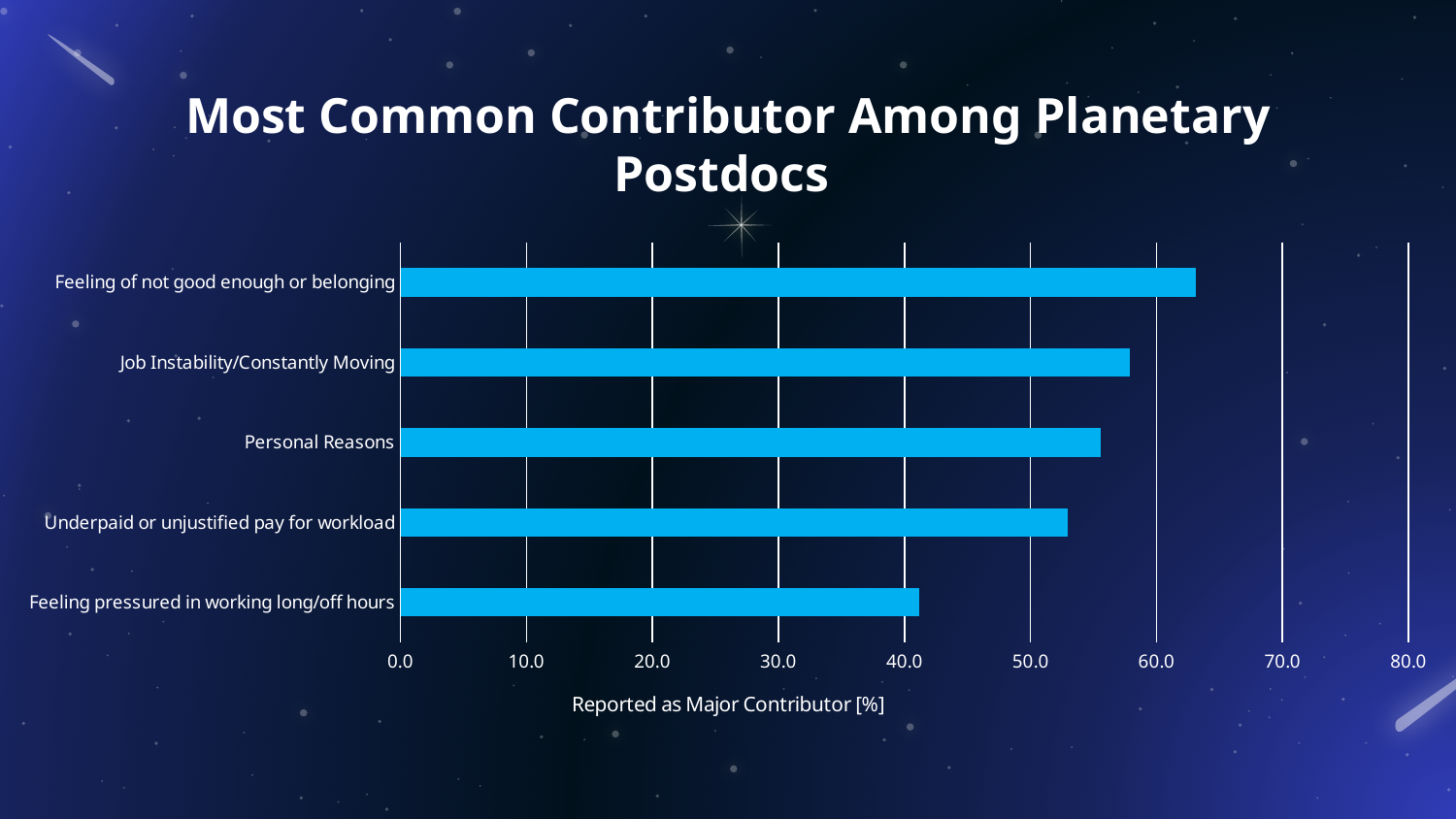
What kind of chart is shown on the slide? bar chart Is the value for Job Instability/Constantly Moving greater or less than 60.0? less Which category has the lowest reported percentage? Feeling pressured in working long/off hours What is the label of the horizontal axis? Reported as Major Contributor [%] Is the value for Feeling of not good enough or belonging greater or less than 60.0? greater Is the value for Personal Reasons greater or less than 50.0? greater Which category has the highest reported percentage? Feeling of not good enough or belonging How many categories are plotted in the chart? 5 What is the title of the chart? Most Common Contributor Among Planetary Postdocs Which is larger: the value for Job Instability/Constantly Moving or the value for Feeling pressured in working long/off hours? Job Instability/Constantly Moving Which is larger: the value for Feeling of not good enough or belonging or the value for Underpaid or unjustified pay for workload? Feeling of not good enough or belonging